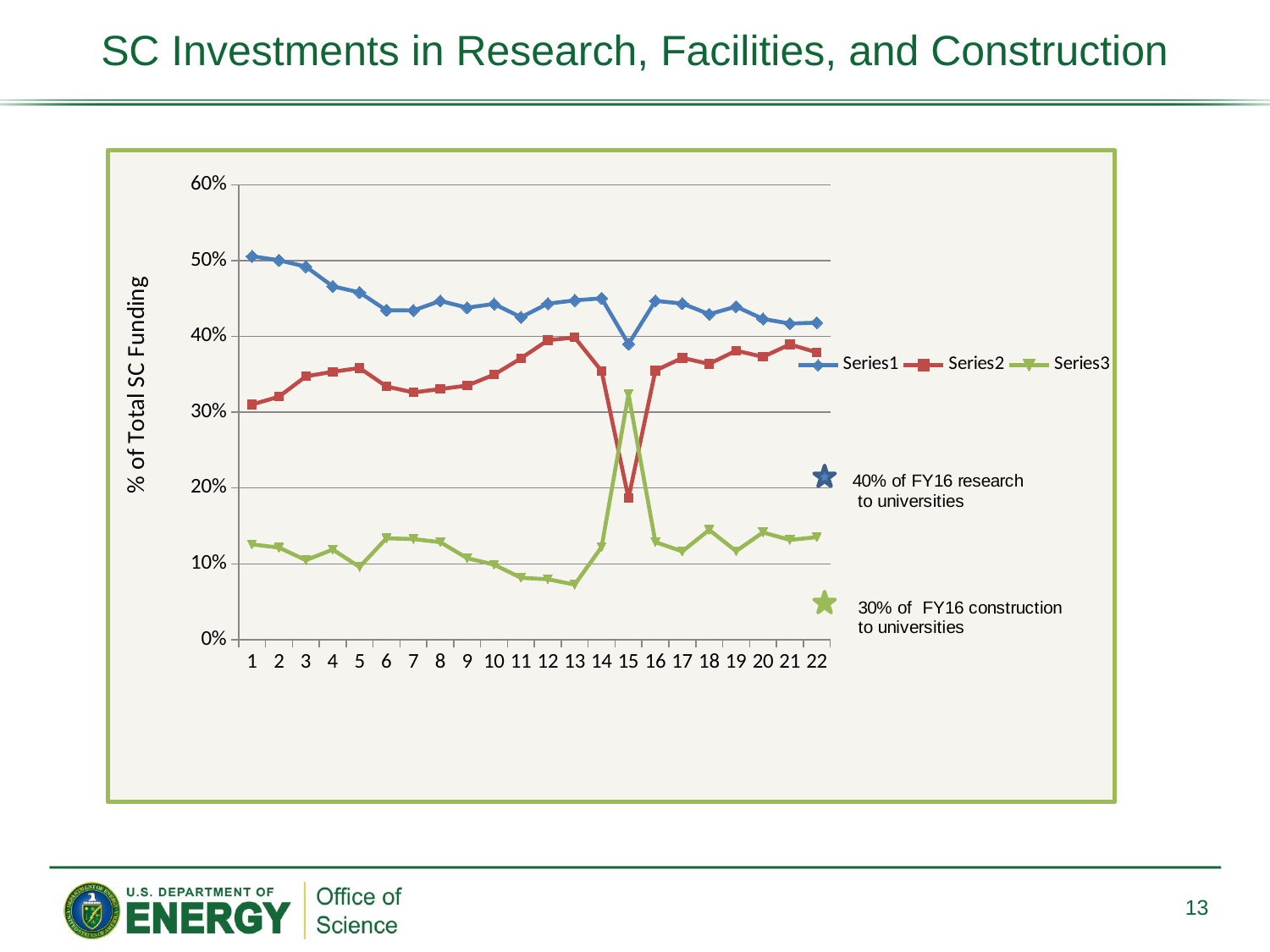
At which point does Series3 reach its highest value? 15 What is the title of the y axis? % of Total SC Funding How many series does the legend list? 3 How many points are plotted along the x axis for each series? 22 Is the value for Series1 at point 1 greater or less than 40%? greater Which series has the highest value at point 1? Series1 Is the value for Series2 at point 15 greater or less than 30%? less Which is larger at point 5, Series1 or Series2? Series1 Is the value for Series3 at point 13 greater or less than 10%? less What kind of chart is shown on the slide? line chart At which point does Series2 reach its lowest value? 15